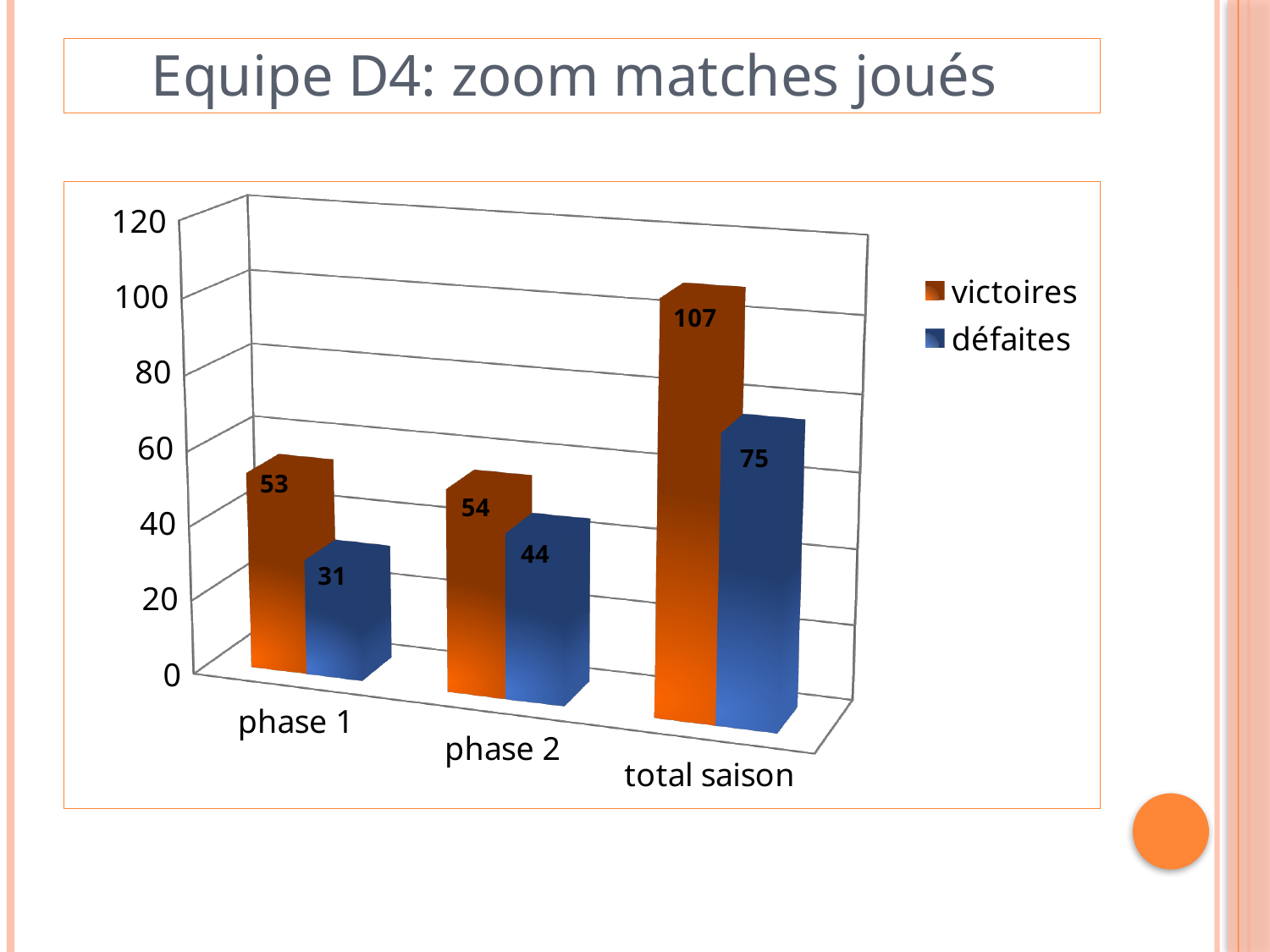
Which is larger for phase 2: victoires or défaites? victoires What is the difference between victoires and défaites for total saison? 32 Which category has the lowest value for défaites? phase 1 What is the value of victoires for total saison? 107 How many categories are shown on the x axis? 3 What is the value of victoires for phase 1? 53 What is the value of défaites for phase 2? 44 Which category has the highest value for défaites? total saison What kind of chart is shown on the slide? bar chart What is the value of défaites for total saison? 75 How many series does the legend list? 2 What is the difference between victoires and défaites for phase 1? 22